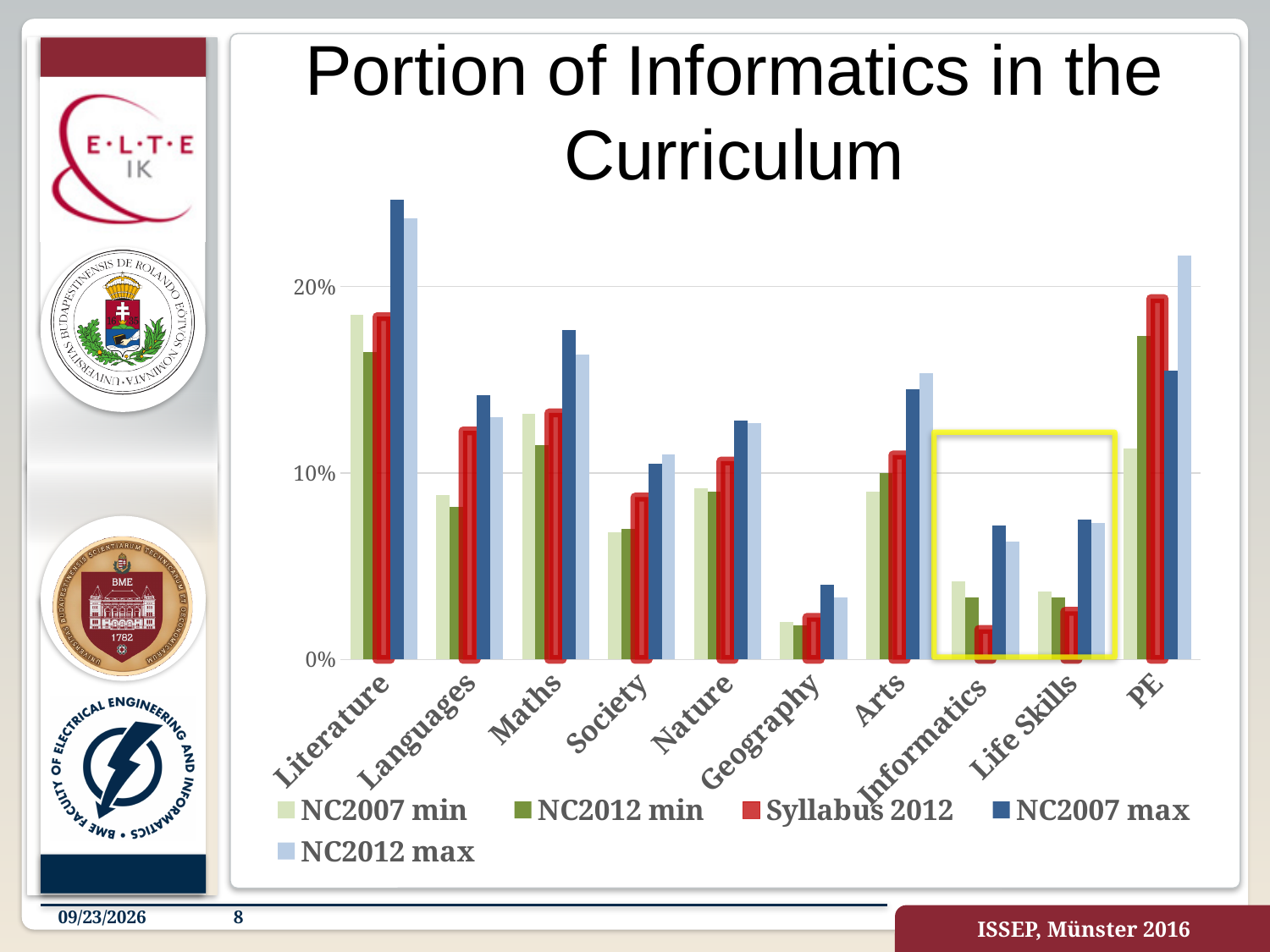
Is the NC2007 max value for Literature greater or less than 20%? greater Is the Syllabus 2012 value for Languages greater or less than 10%? greater What is the title of the chart? Portion of Informatics in the Curriculum Which category has the lowest Syllabus 2012 value? Informatics What kind of chart is shown on the slide? bar chart Which two categories are highlighted with a yellow box on the chart? Informatics and Life Skills Which category has the highest NC2007 max value? Literature How many subject categories are shown on the x axis? 10 Which is larger: the NC2007 max value for Maths or the NC2007 max value for Languages? Maths Which category has the highest Syllabus 2012 value? PE Is the NC2007 max value for Informatics greater or less than 10%? less How many series does the legend list? 5